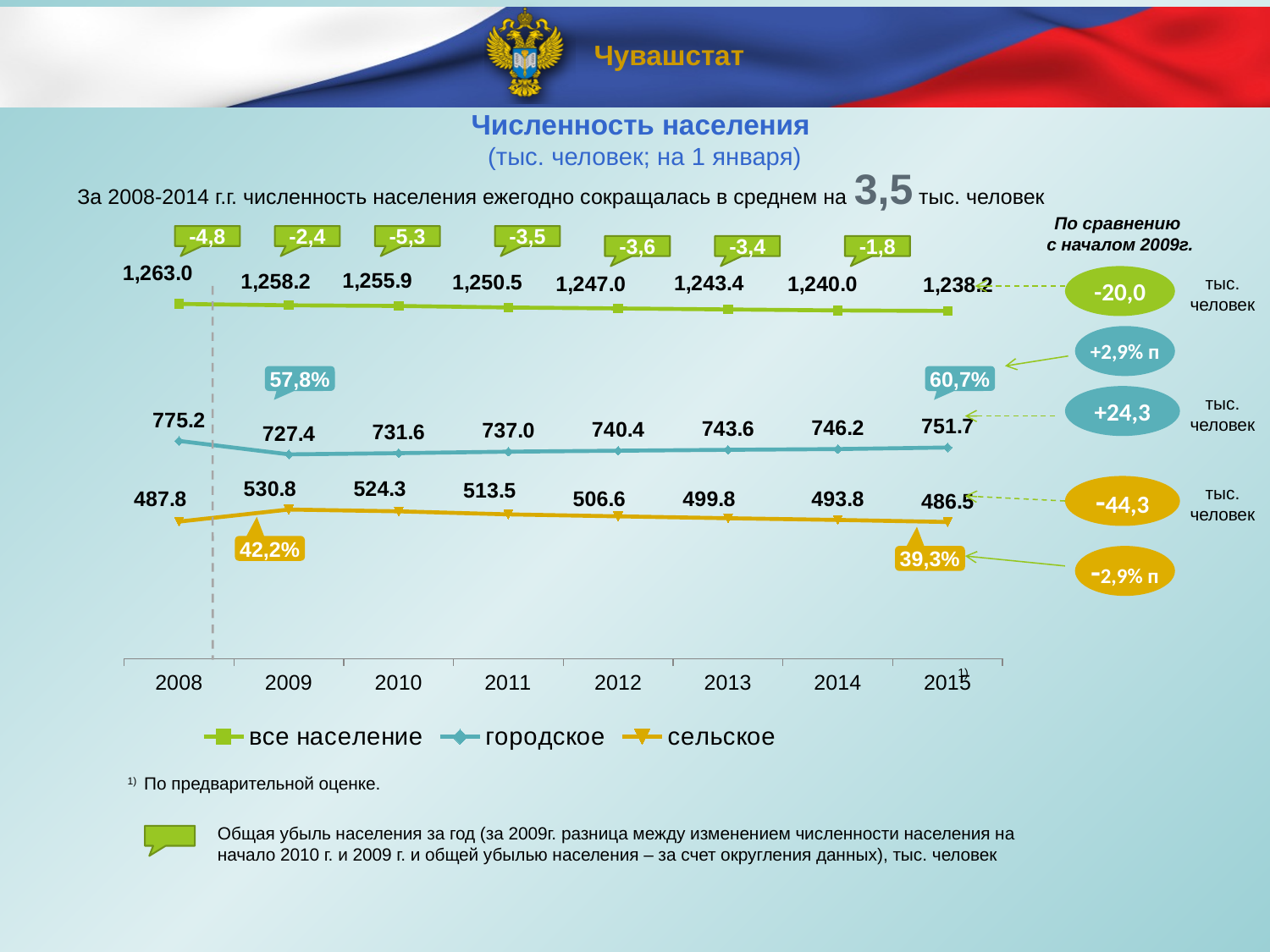
Does the 'все население' series rise or fall from 2008 to 2015? fall What type of chart is shown on the slide? line chart In which year is the 'все население' series lowest? 2015 In which year is the 'сельское' series highest? 2009 What is the value for 'городское' in 2015? 751.7 How many series does the legend list? 3 What is the value for 'все население' in 2008? 1,263.0 Which is larger in 2008: the 'городское' value or the 'сельское' value? городское What is the value for 'сельское' in 2012? 506.6 What is the title of the chart? Численность населения How many years are shown on the x axis? 8 What is the difference between the 'городское' values in 2015 and 2009? 24.3